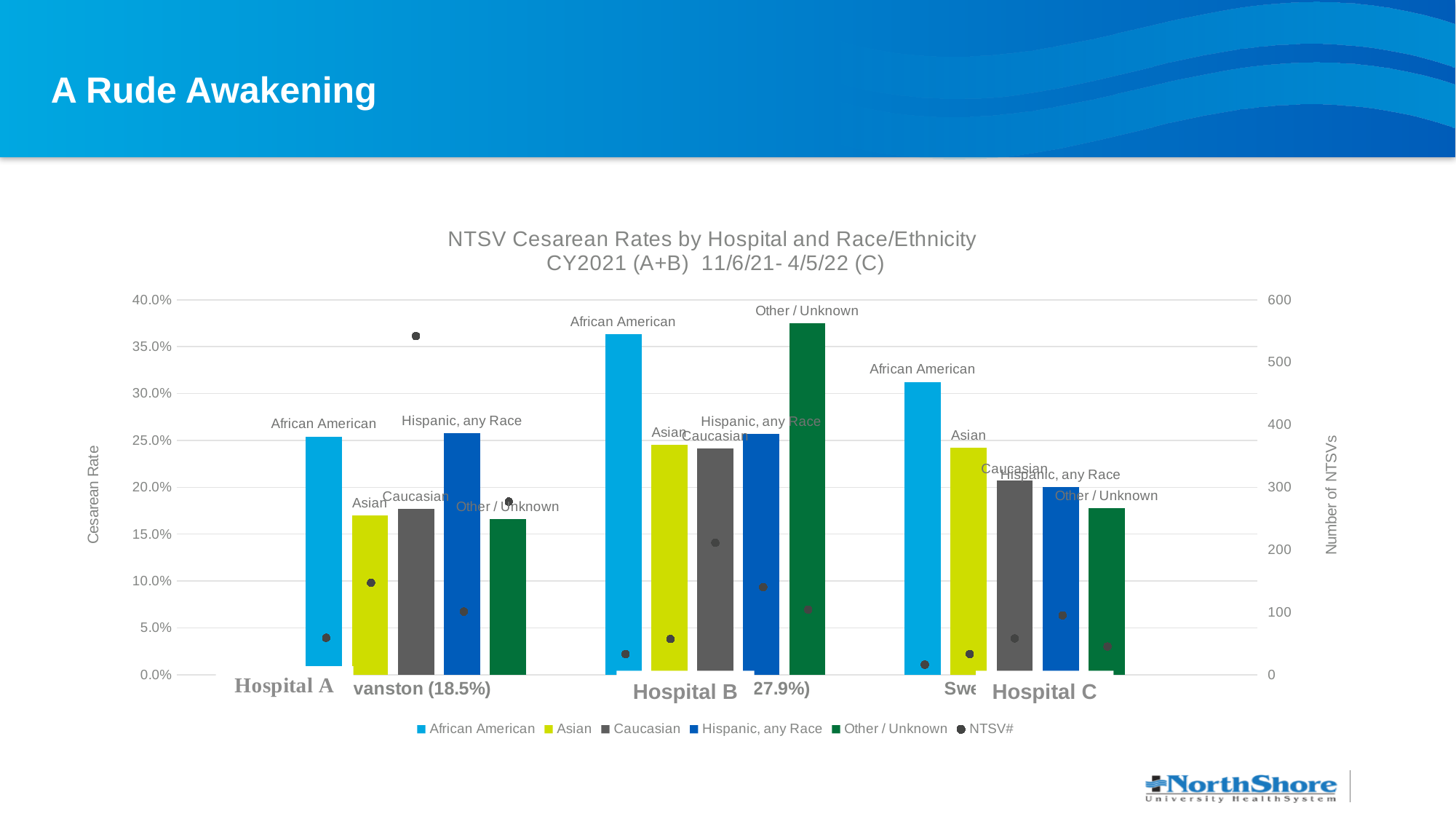
Is the cesarean rate for Asian at Hospital A greater or less than 20.0%? less What kind of chart is shown on the slide? bar chart Which hospital has the higher cesarean rate for African American, Hospital B or Hospital C? Hospital B How many hospitals are shown along the x axis? 3 Which race/ethnicity group has the highest cesarean rate at Hospital B? Other / Unknown How many series does the legend list? 6 Which race/ethnicity group has the lowest cesarean rate at Hospital C? Other / Unknown Which race/ethnicity group has the highest cesarean rate at Hospital C? African American Is the cesarean rate for African American at Hospital C greater or less than 30.0%? greater Is the cesarean rate for African American at Hospital B greater or less than 35.0%? greater What is the title of the right-hand vertical axis? Number of NTSVs